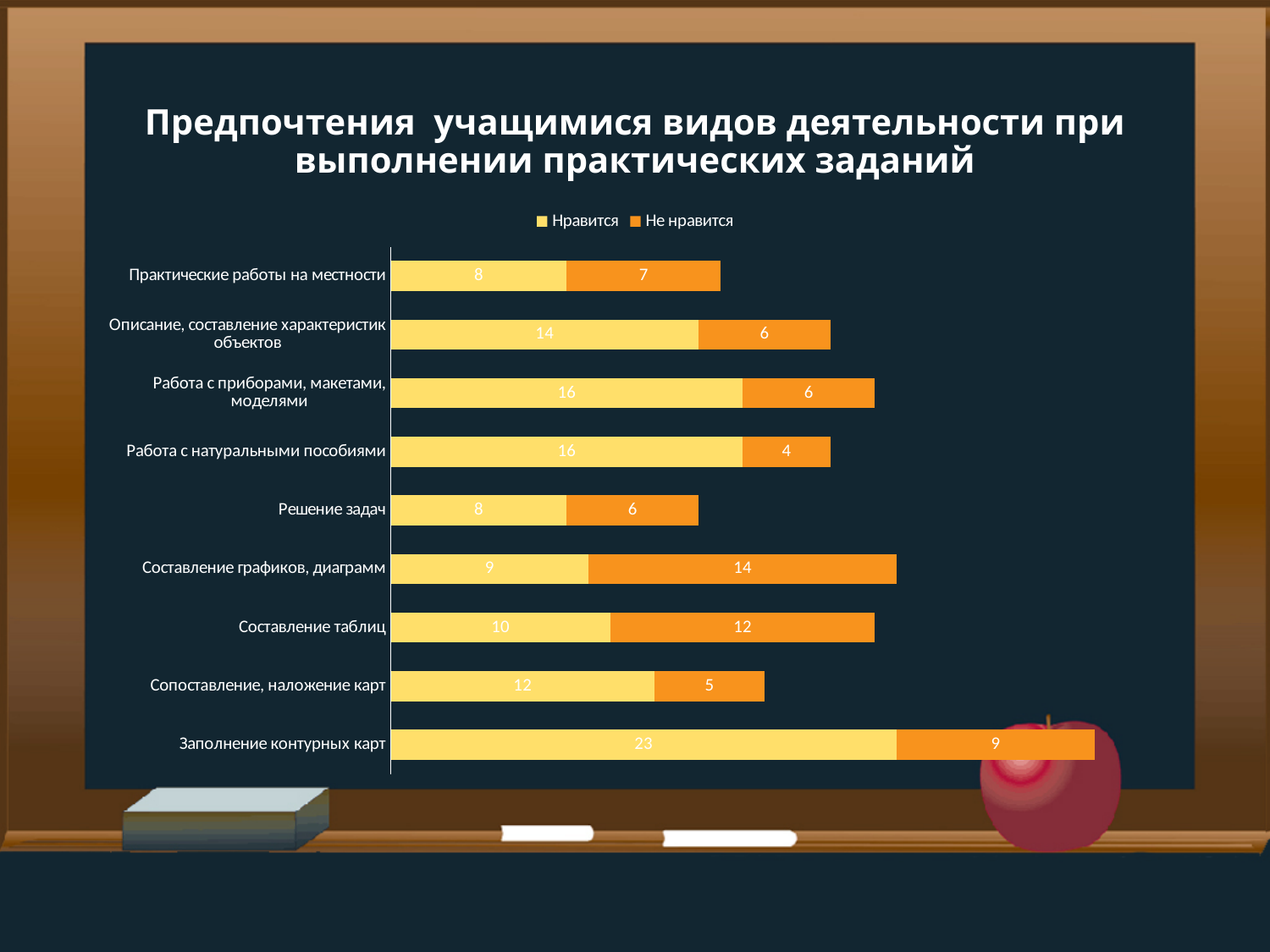
What is the value of "Нравится" for "Заполнение контурных карт"? 23 How many categories are plotted on the chart? 9 What is the total of the stacked bar for "Составление таблиц"? 22 Which category has the highest "Нравится" value? Заполнение контурных карт Which series is shown in orange in the legend? Не нравится What kind of chart is shown on the slide? Stacked bar chart Which category has the lowest "Не нравится" value? Работа с натуральными пособиями How many series does the legend list? 2 What is the value of "Нравится" for "Решение задач"? 8 What is the value of "Не нравится" for "Составление графиков, диаграмм"? 14 What is the difference between "Нравится" and "Не нравится" for "Работа с натуральными пособиями"? 12 For "Составление графиков, диаграмм", which is larger: "Нравится" or "Не нравится"? Не нравится